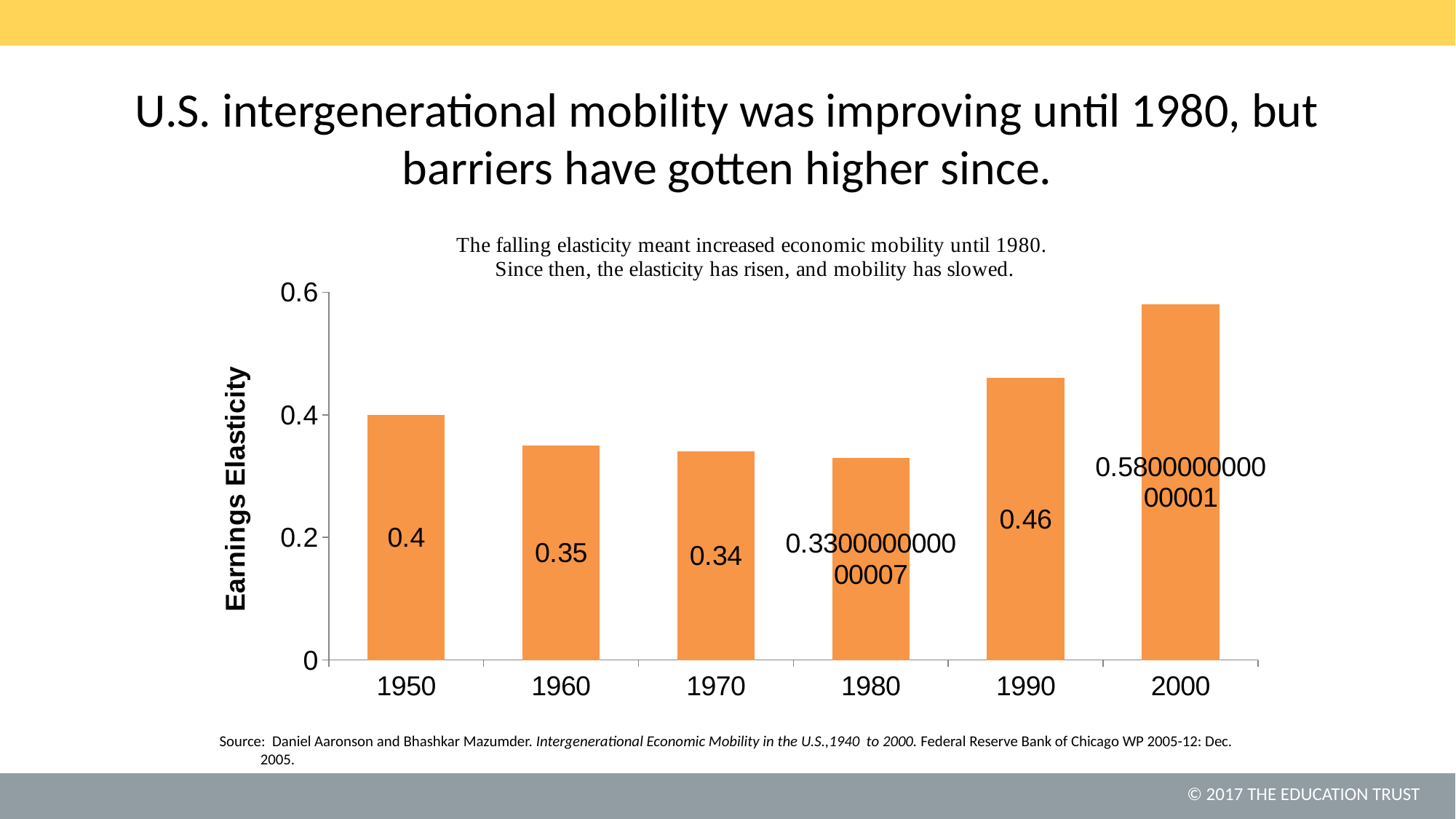
What is the earnings elasticity value for 1970? 0.34 What is the difference between the earnings elasticity for 1950 and 1960? 0.05 What is the title of the y axis of the chart? Earnings Elasticity What kind of chart is shown on the slide? Bar chart How many years are shown on the x axis of the chart? 6 What is the earnings elasticity value for 1990? 0.46 Which year has a higher earnings elasticity, 1990 or 1960? 1990 Which year has the lowest earnings elasticity? 1980 What is the earnings elasticity value for 1950? 0.4 Is the earnings elasticity for 2000 greater or less than 0.4? greater What is the earnings elasticity value for 1960? 0.35 Which year has the highest earnings elasticity? 2000